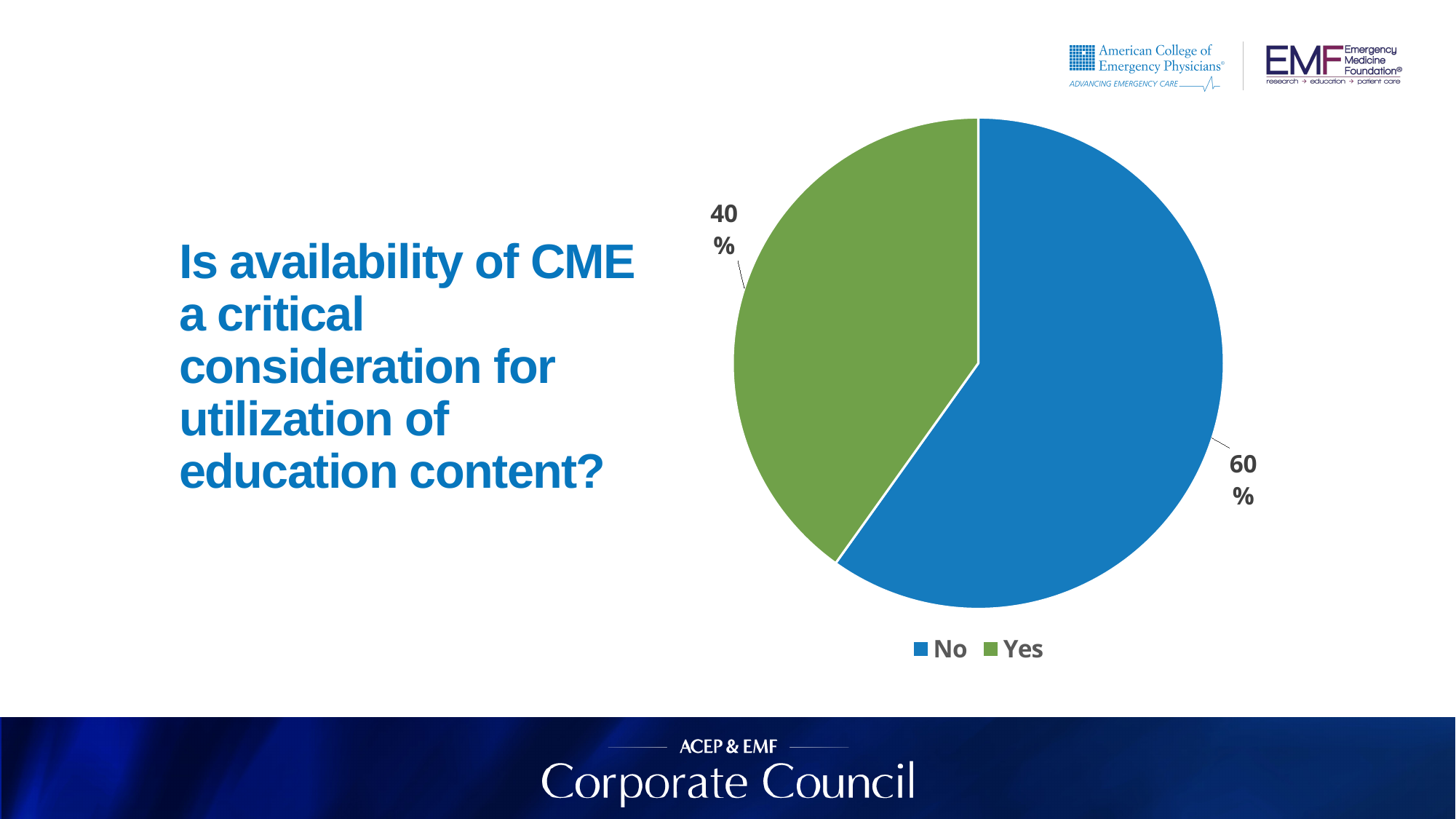
What is the difference in percentage points between the "No" slice and the "Yes" slice? 20 What colour is the "Yes" slice in the pie chart? green Which slice of the pie is the largest? No What type of chart is shown on the slide? pie chart Which slice of the pie is the smallest? Yes Which is larger, the "Yes" slice or the "No" slice? No What percentage of the pie is labelled "Yes"? 40% What share of the pie does the "No" slice represent? 60% How many slices does the pie chart have? 2 How many entries does the legend list? 2 What percentage of the pie is labelled "No"? 60% What colour is the "No" slice in the pie chart? blue